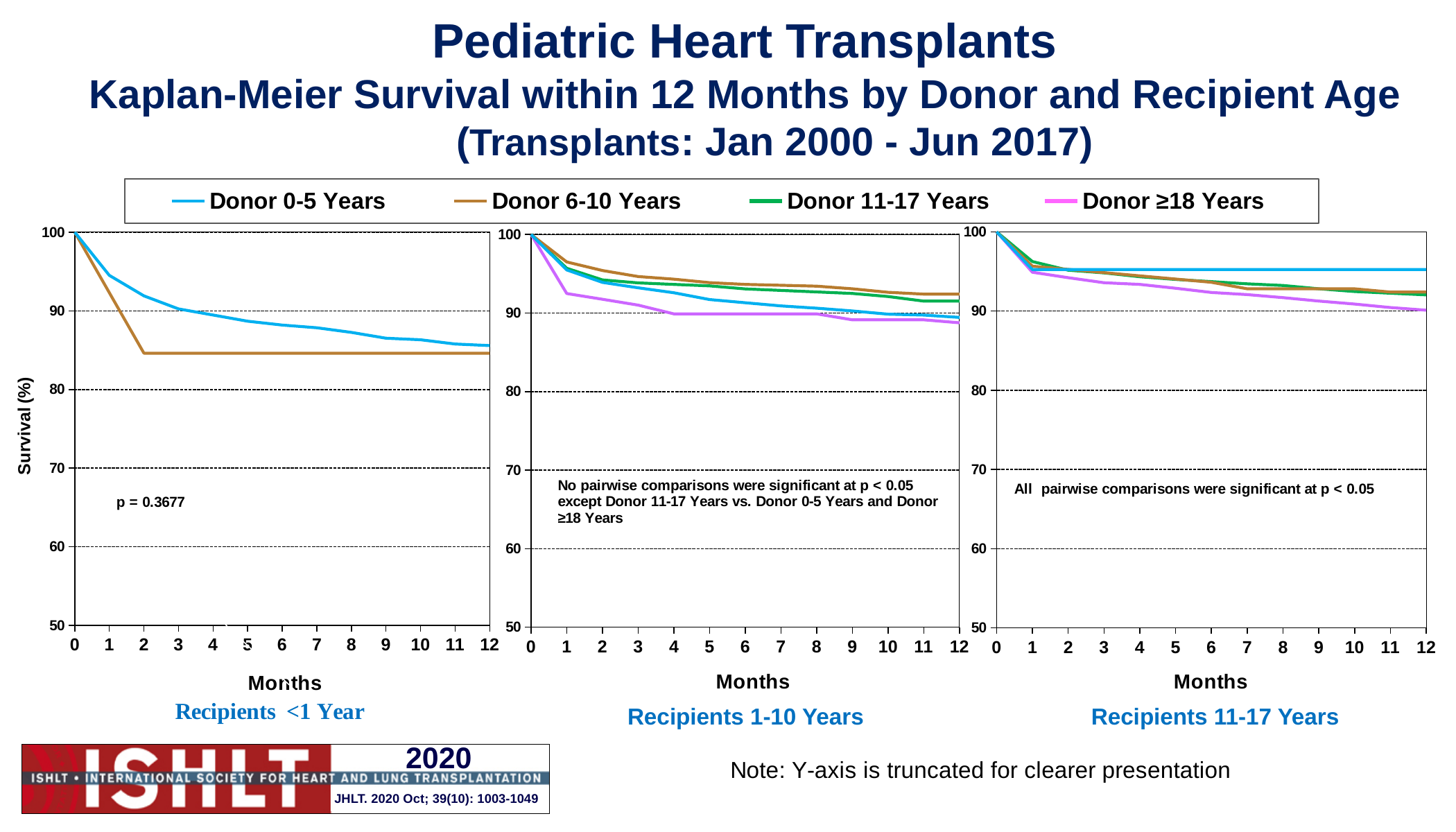
In the Recipients 1-10 Years chart, which donor group has the highest survival at 12 months? Donor 6-10 Years In the Recipients 11-17 Years chart, which donor group has the highest survival at 12 months? Donor 0-5 Years In the Recipients 11-17 Years chart, do the survival curves rise or fall as months increase? fall In the Recipients <1 Year chart, is the survival for Donor 6-10 Years at 12 months greater or less than 90? less How many donor age groups does the legend list? 4 What kind of chart is used on this slide to show survival by donor age? Line chart In the Recipients <1 Year chart, what p-value is printed? p = 0.3677 In the Recipients 11-17 Years chart, which donor group has the lowest survival at 12 months? Donor ≥18 Years In the Recipients 1-10 Years chart, which donor group has the lowest survival at month 4? Donor ≥18 Years How many charts are shown on the slide? 3 In the Recipients <1 Year chart, which donor group has the higher survival at month 3? Donor 0-5 Years In the Recipients 1-10 Years chart, is the survival for Donor ≥18 Years at 12 months greater or less than 90? less